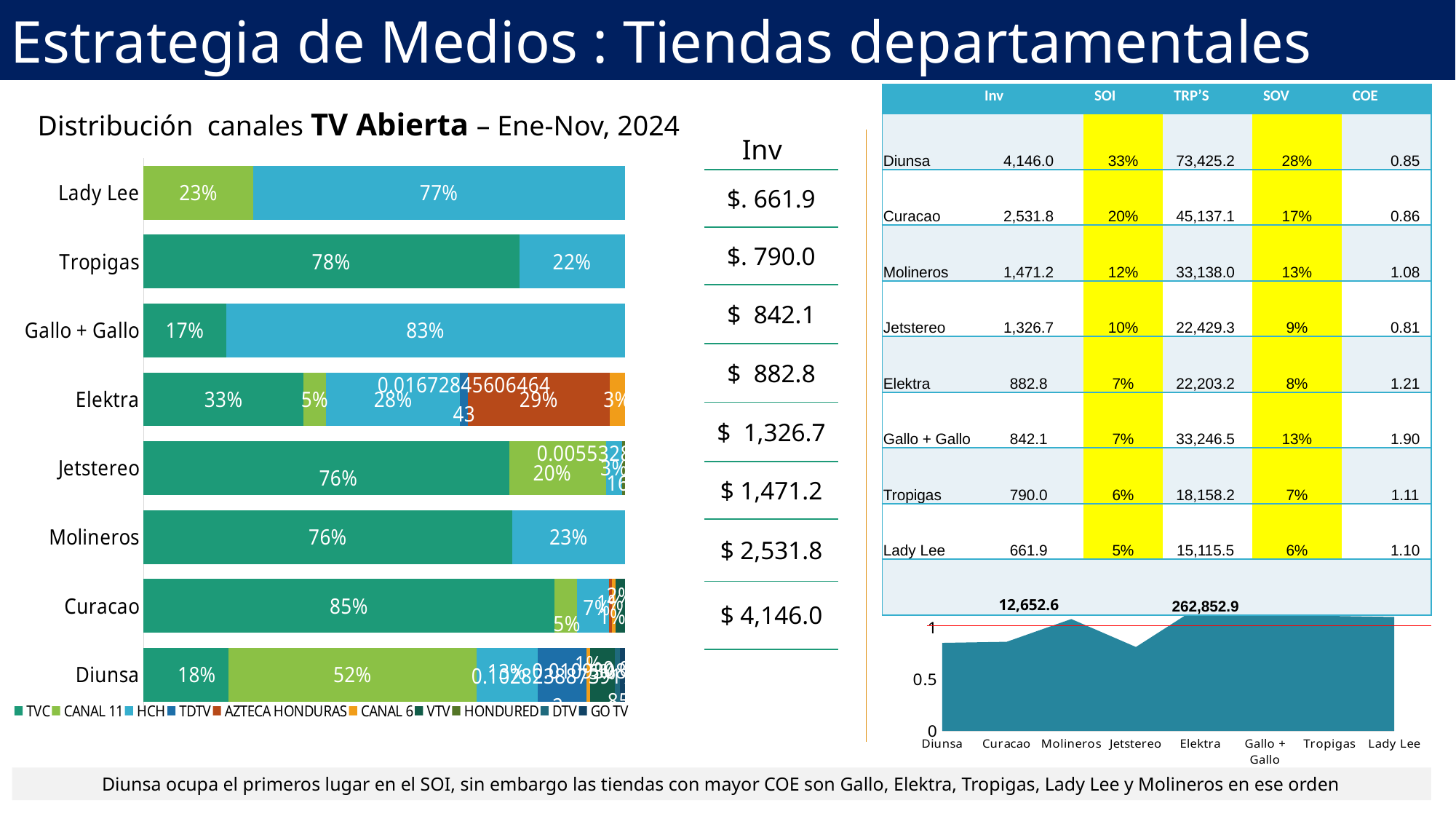
In the 'Distribución canales TV Abierta' chart, what is the TVC share for Tropigas? 78% How many stores are shown in the 'Distribución canales TV Abierta' chart? 8 In the 'Distribución canales TV Abierta' chart, which is larger: the TVC share for Molineros or the TVC share for Diunsa? Molineros How many series does the legend of the 'Distribución canales TV Abierta' chart list? 10 In the 'Distribución canales TV Abierta' chart, what percentage of Lady Lee's distribution goes to HCH? 77% In the 'Distribución canales TV Abierta' chart, which store has the highest TVC share? Curacao What kind of chart is the 'Distribución canales TV Abierta' chart? Stacked bar chart In the 'Distribución canales TV Abierta' chart, what is the AZTECA HONDURAS share for Elektra? 29% In the area chart at the bottom right of the slide, is the value for Gallo + Gallo greater or less than 1? greater In the 'Distribución canales TV Abierta' chart, what is the CANAL 11 share for Diunsa? 52%